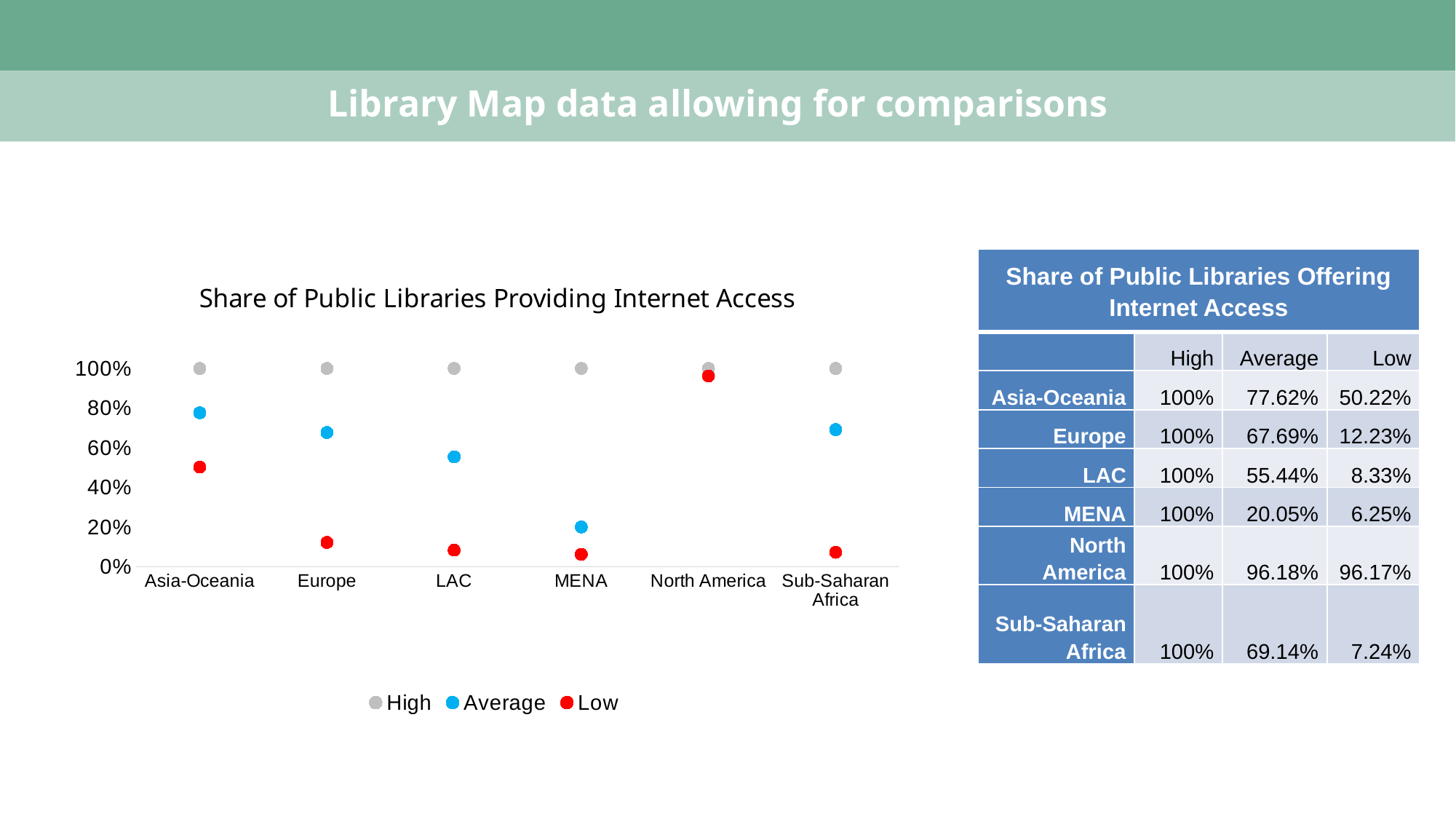
Which region has the highest Average value in the chart? North America Which region has the lowest Average value in the chart? MENA How many series does the chart legend list? 3 Which region has the highest Low value in the chart? North America What is the title of the chart? Share of Public Libraries Providing Internet Access What is the Average value for Asia-Oceania? 77.62% Which is larger, the Average value for Europe or the Average value for LAC? Europe How many regions are shown on the x axis of the chart? 6 Is the Average value for Sub-Saharan Africa greater or less than 60%? greater Is the Low value for LAC greater or less than 20%? less What is the difference between the Average and Low values for Asia-Oceania? 27.40% What is the Low value for Europe? 12.23%